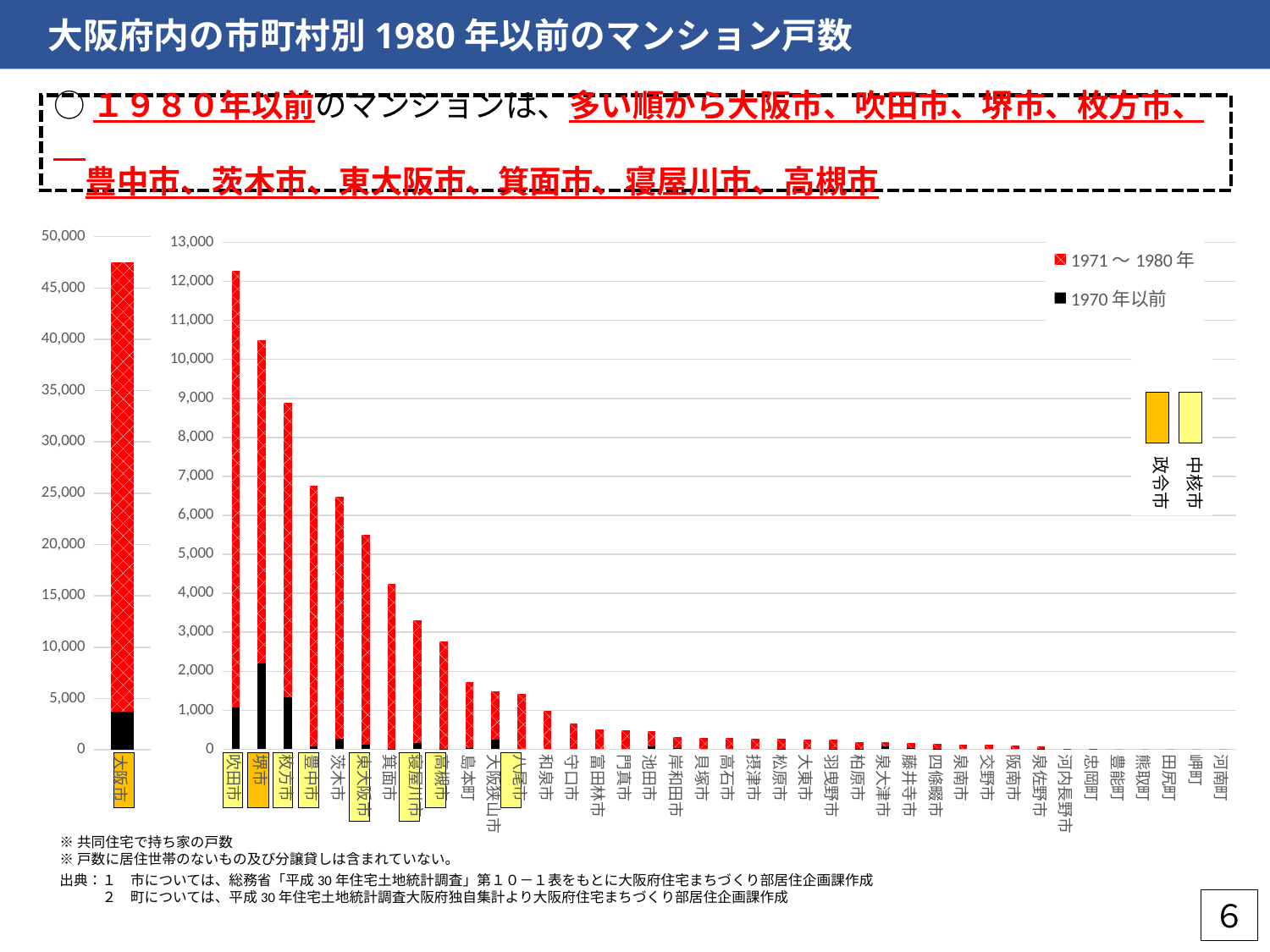
In the right-hand chart, is the total value for 豊中市 greater or less than 7,000? less In the right-hand chart, is the total value for 東大阪市 greater or less than 5,000? greater What kind of chart is used on this slide to show the number of condominium units by municipality? Stacked bar chart In the right-hand chart, do the total values rise or fall moving from left to right along the x axis? fall Which legend entry is shown with the black solid fill in the chart? 1970年以前 How many series does the legend of the right-hand chart list? 2 In the right-hand chart, which has a larger total, 箕面市 or 寝屋川市? 箕面市 How many municipalities are shown on the x axis of the right-hand chart? 39 In the right-hand chart, is the total value for 堺市 greater or less than 10,000? greater In the right-hand chart (municipalities other than 大阪市), which municipality has the highest total number of units? 吹田市